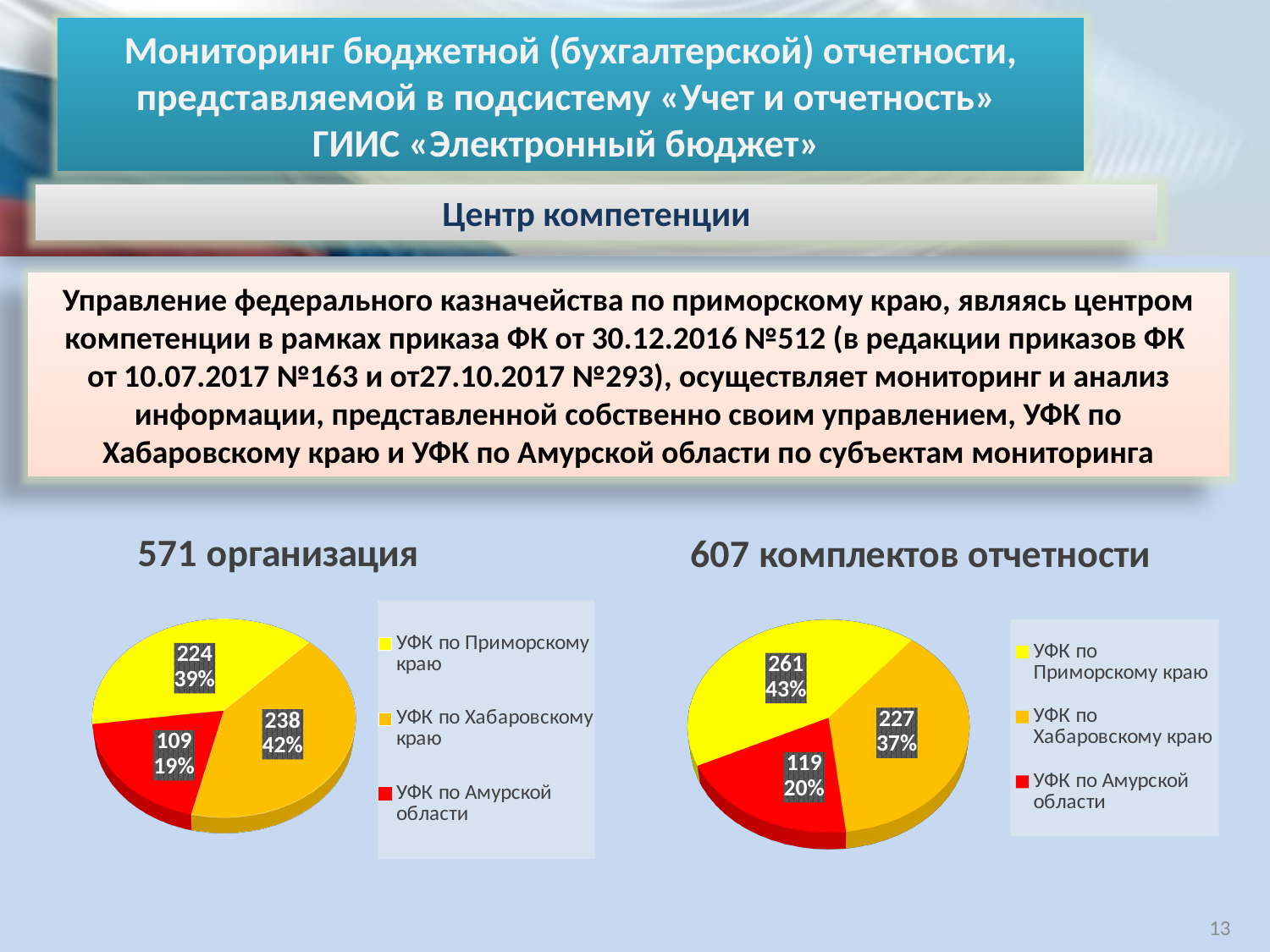
In the "571 организация" chart, what is the value for УФК по Хабаровскому краю? 238 In the "607 комплектов отчетности" chart, what is the difference between the values for УФК по Приморскому краю and УФК по Амурской области? 142 In the "571 организация" chart, what share of the pie does УФК по Амурской области have? 19% In the "607 комплектов отчетности" chart, what share of the pie does УФК по Хабаровскому краю have? 37% In the "607 комплектов отчетности" chart, what is the value for УФК по Приморскому краю? 261 What type of chart is the "607 комплектов отчетности" chart? Pie chart In the "607 комплектов отчетности" chart, which category has the largest slice? УФК по Приморскому краю How many categories does the "571 организация" chart show? 3 In the "607 комплектов отчетности" chart, which is larger: the value for УФК по Амурской области or УФК по Хабаровскому краю? УФК по Хабаровскому краю In the "571 организация" chart, which category has the smallest slice? УФК по Амурской области In the "571 организация" chart, what is the difference between the values for УФК по Хабаровскому краю and УФК по Приморскому краю? 14 In the "571 организация" chart, which category has the largest slice? УФК по Хабаровскому краю